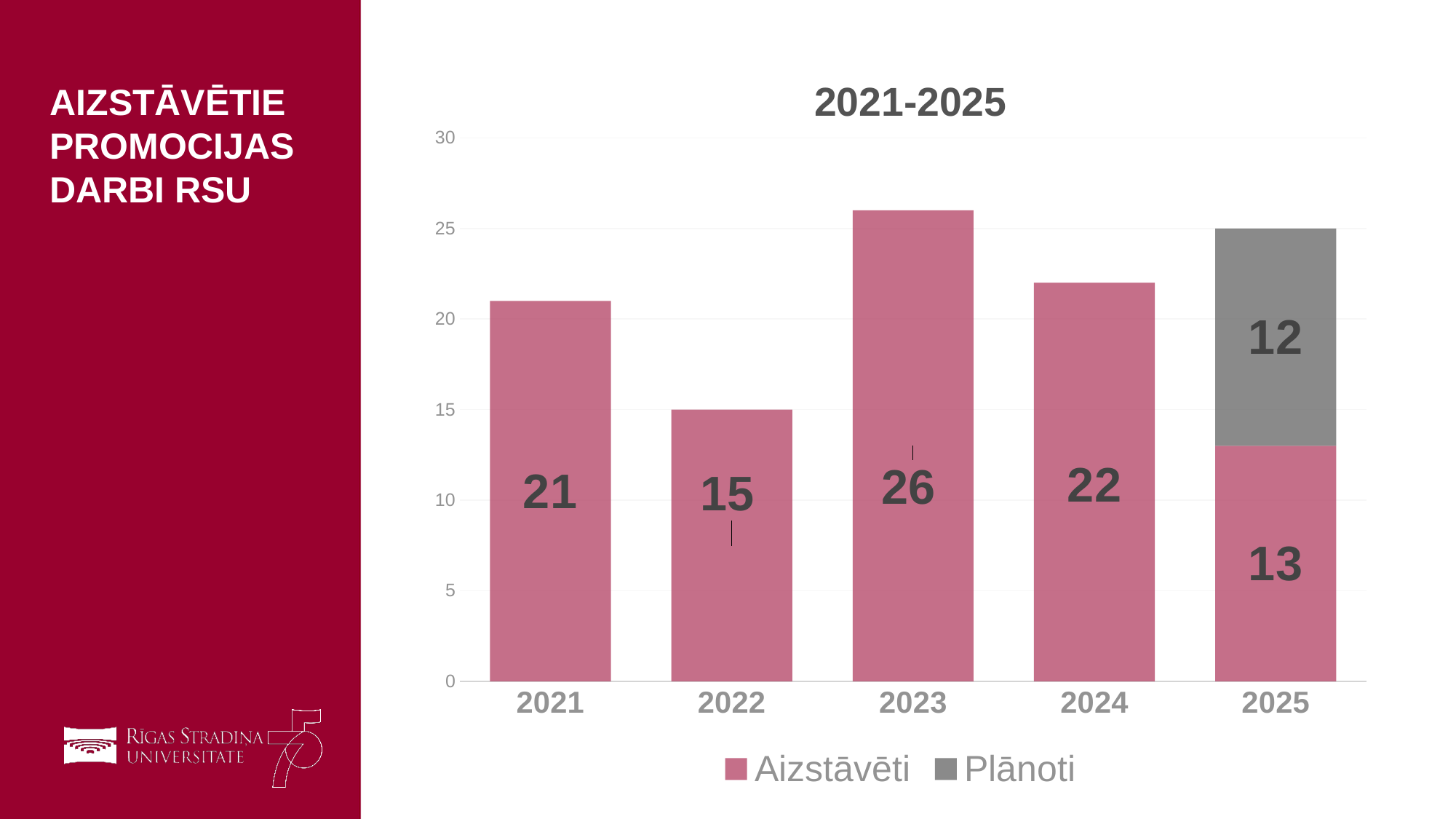
Which year has the highest Aizstāvēti value? 2023 What is the Aizstāvēti value for 2022? 15 What is the Aizstāvēti value for 2023? 26 How many series does the legend list? 2 How many years are shown on the x axis? 5 What is the title of the chart? 2021-2025 Which is larger, the Aizstāvēti value for 2021 or for 2024? 2024 Which year has the lowest Aizstāvēti value? 2025 What is the total of the stacked bar for 2025? 25 What is the difference between the Aizstāvēti values for 2023 and 2022? 11 What kind of chart is shown on the slide? Bar chart What is the Plānoti value for 2025? 12